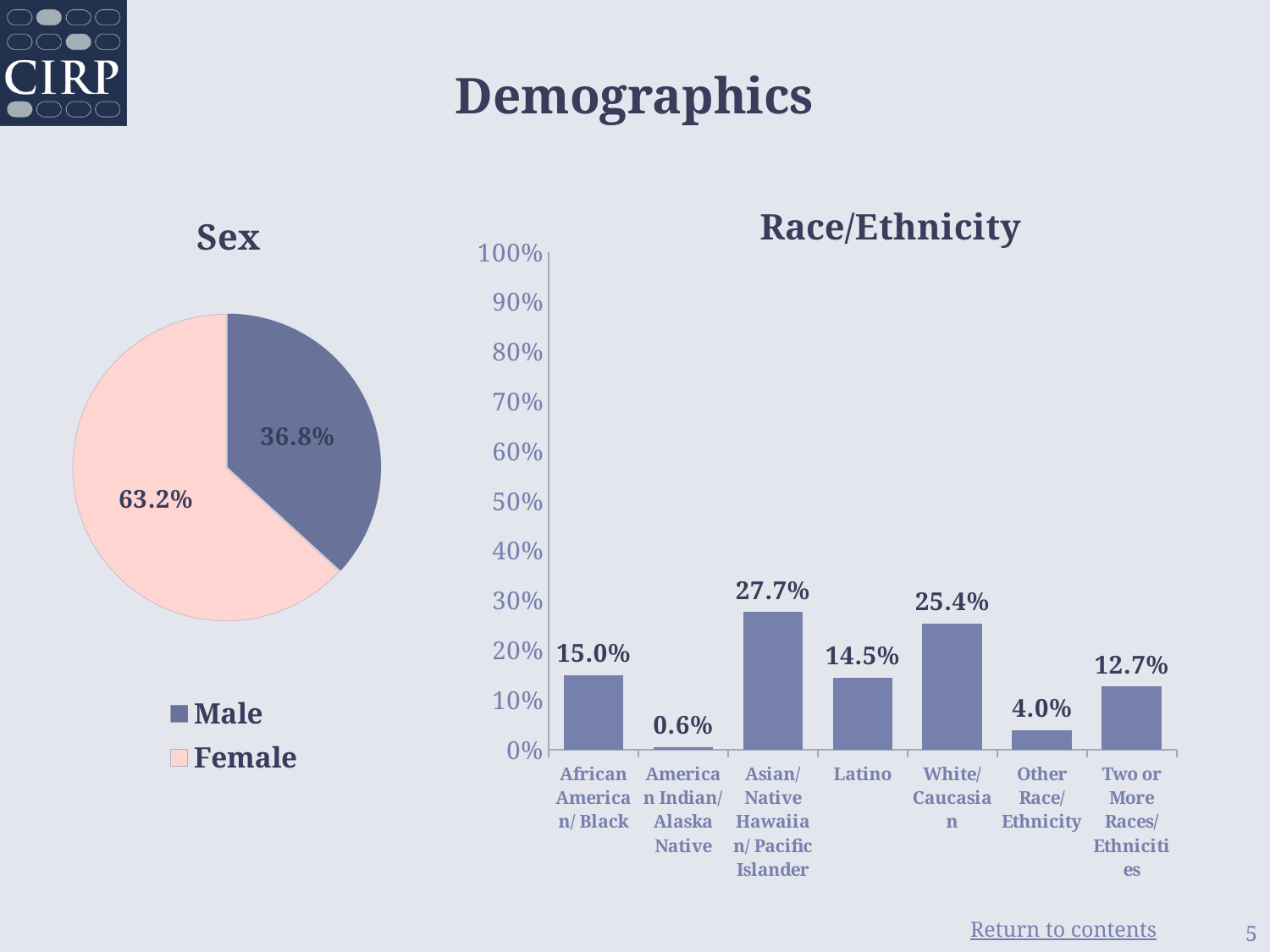
In the Sex pie chart, what percentage is Female? 63.2% In the Race/Ethnicity chart, what is the value for Latino? 14.5% What kind of chart is the Race/Ethnicity chart? Bar chart In the Race/Ethnicity chart, what is the difference between Asian/Native Hawaiian/Pacific Islander and White/Caucasian? 2.3% In the Sex pie chart, which slice is larger, Male or Female? Female In the Race/Ethnicity chart, which category has the highest value? Asian/Native Hawaiian/Pacific Islander In the Race/Ethnicity chart, which category has the lowest value? American Indian/Alaska Native In the Race/Ethnicity chart, what is the value for White/Caucasian? 25.4% How many categories are shown in the Race/Ethnicity bar chart? 7 In the Sex pie chart, what percentage is Male? 36.8% In the Sex pie chart, what is the difference between the Female and Male shares? 26.4% What kind of chart is the Sex chart? Pie chart